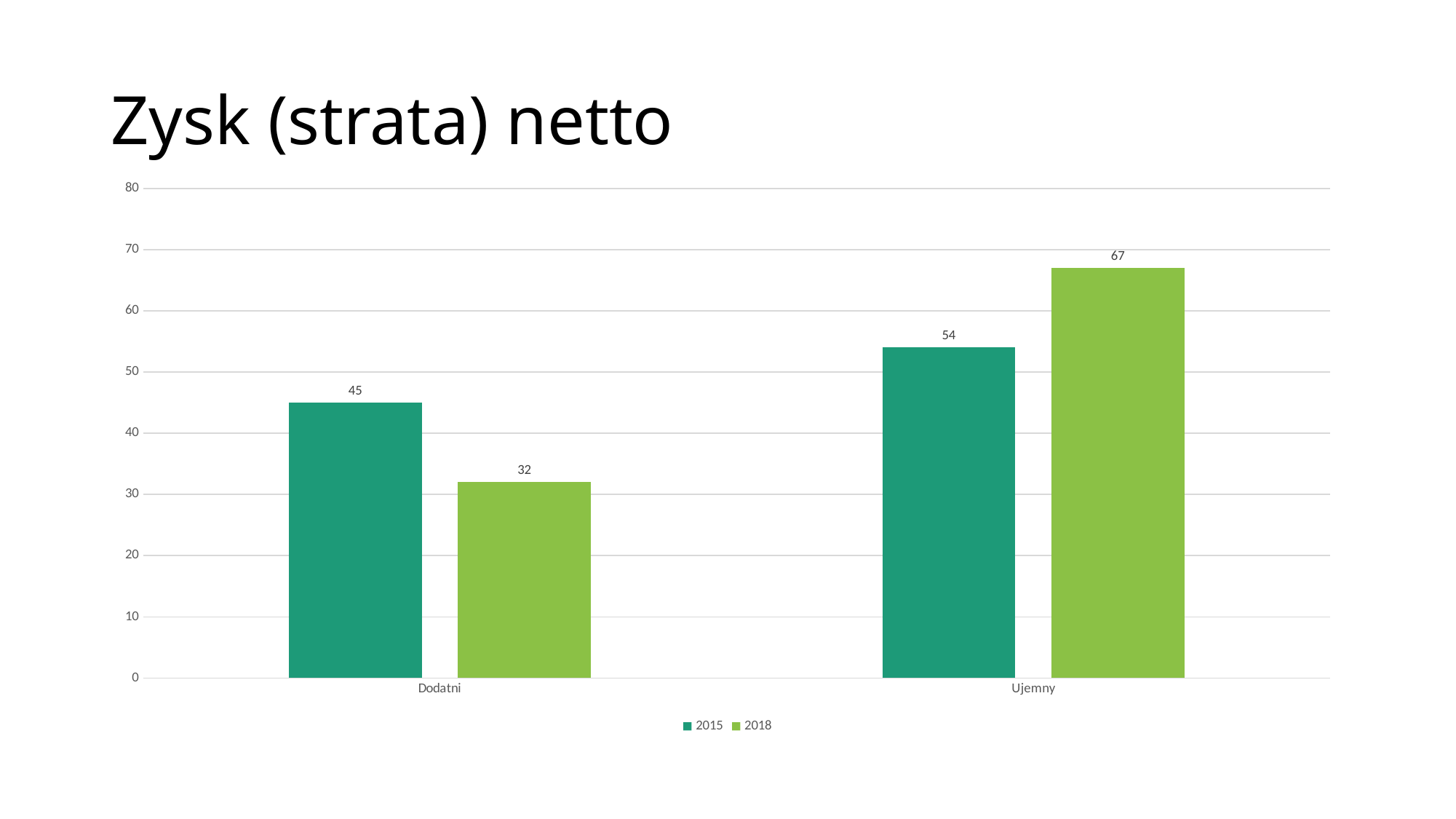
Which category has the highest value in the 2018 series? Ujemny What kind of chart is shown on the slide? Bar chart What is the value for Ujemny in the 2015 series? 54 How many series does the legend list? 2 What is the difference between the 2015 and 2018 values for Dodatni? 13 What is the value for Dodatni in the 2018 series? 32 Which category has the lowest value in the 2015 series? Dodatni Which is larger for Dodatni: the 2015 value or the 2018 value? 2015 How many categories are shown on the x axis? 2 What is the value for Dodatni in the 2015 series? 45 What is the value for Ujemny in the 2018 series? 67 What is the difference between the 2018 and 2015 values for Ujemny? 13